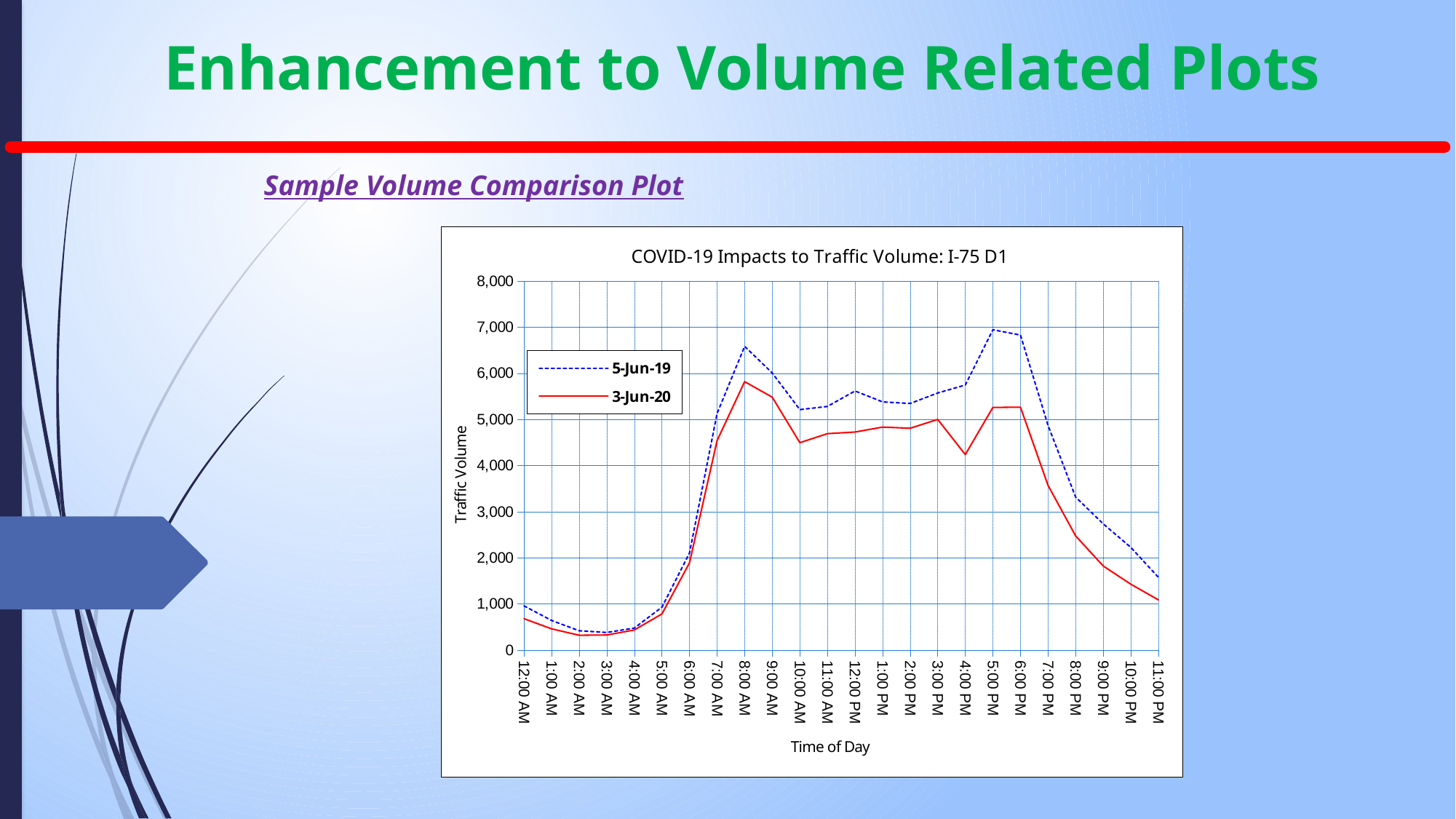
What kind of chart is shown on the slide? Line chart Is the 3-Jun-20 value at 2:00 AM greater or less than 1,000? less At 4:00 PM, which series has the higher traffic volume, 5-Jun-19 or 3-Jun-20? 5-Jun-19 Is the 5-Jun-19 value at 8:00 AM greater or less than 6,000? greater At what time of day does the 3-Jun-20 series reach its highest value? 8:00 AM What is the label of the y axis? Traffic Volume At what time of day does the 5-Jun-19 series reach its highest value? 5:00 PM What is the title of the chart? COVID-19 Impacts to Traffic Volume: I-75 D1 How many time-of-day points are plotted along the x axis? 24 Is the 3-Jun-20 value at 4:00 PM greater or less than 5,000? less Does the 3-Jun-20 series rise or fall from 6:00 PM to 11:00 PM? fall How many series does the chart legend list? 2